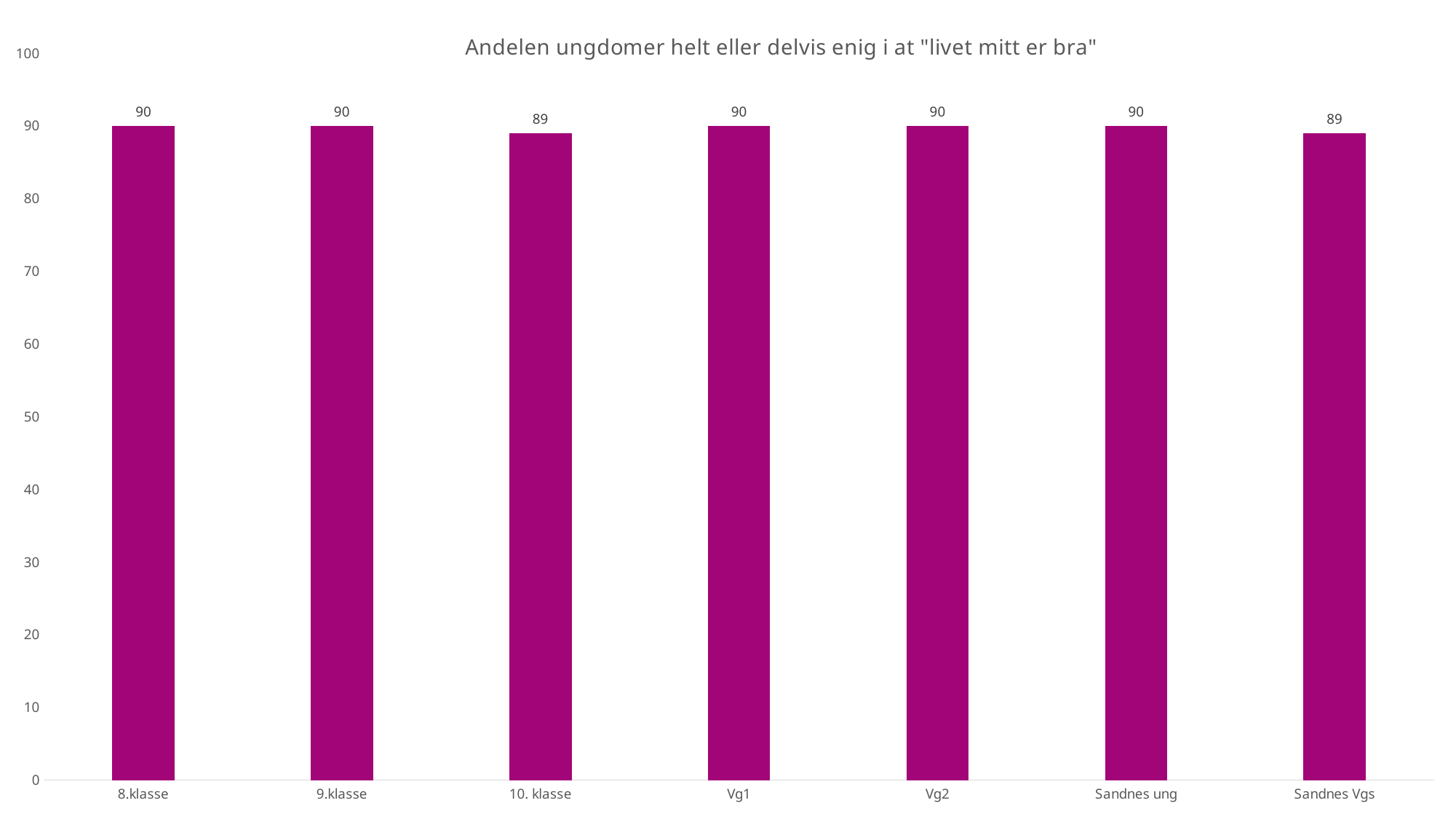
What is the difference between the value for Vg1 and the value for Sandnes Vgs? 1 What is the value for Sandnes Vgs? 89 What is the value for 8.klasse? 90 What colour are the bars in the chart? purple Which is larger, the value for 9.klasse or the value for 10. klasse? 9.klasse What is the value for 10. klasse? 89 What kind of chart is shown on the slide? bar chart What is the value for Sandnes ung? 90 How many categories are shown on the x axis? 7 What is the title of the chart? Andelen ungdomer helt eller delvis enig i at "livet mitt er bra" What is the value for Vg2? 90 Is the value for Vg1 greater or less than 80? greater